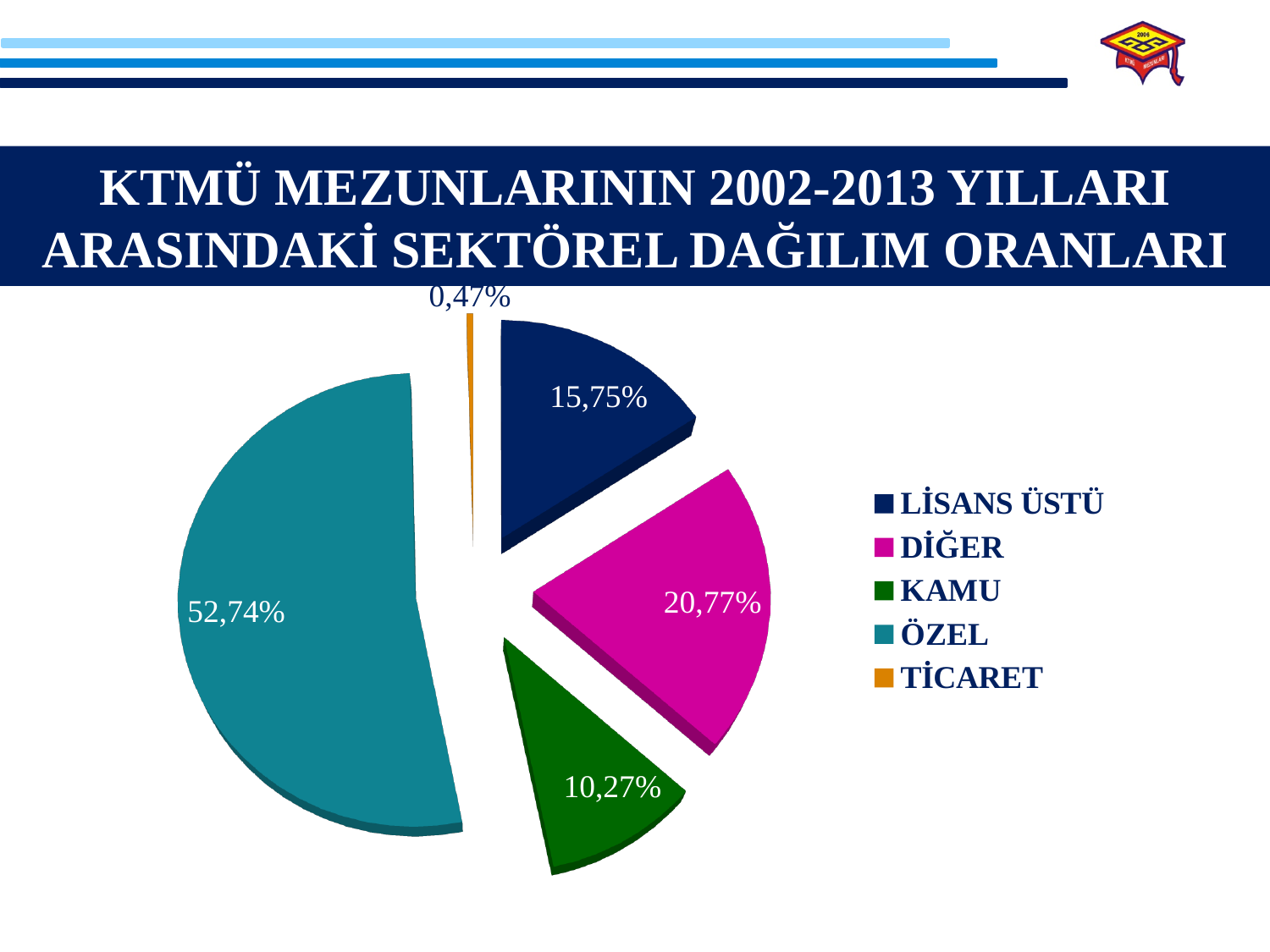
Which category has the largest share of the pie? ÖZEL How many categories does the legend list? 5 What colour is the KAMU slice? Green What percentage does the KAMU slice show? 10,27% What percentage does the TİCARET slice show? 0,47% What percentage does the ÖZEL slice show? 52,74% Which is larger, the share for DİĞER or the share for LİSANS ÜSTÜ? DİĞER What percentage does the LİSANS ÜSTÜ slice show? 15,75% What type of chart is shown on the slide? Pie chart What is the difference in percentage points between ÖZEL and DİĞER? 31,97 What percentage does the DİĞER slice show? 20,77% Which category has the smallest share of the pie? TİCARET